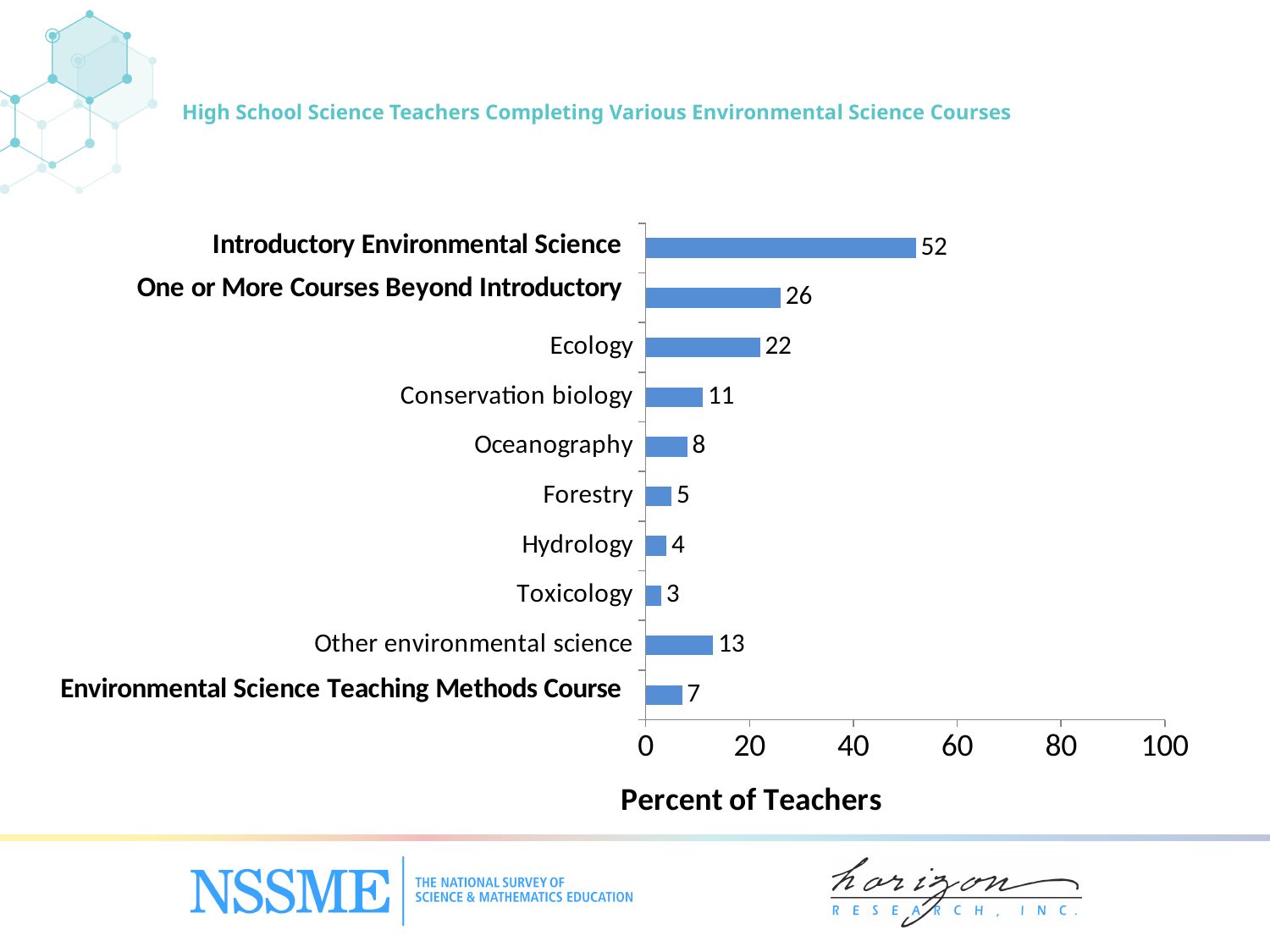
What is the difference between the values for Introductory Environmental Science and One or More Courses Beyond Introductory? 26 What kind of chart is shown on the slide? bar chart What is the value for Conservation biology? 11 Is the value for Oceanography greater or less than 20? less What percent of teachers completed an Environmental Science Teaching Methods Course? 7 What is the label of the horizontal axis? Percent of Teachers Which category has the highest percent of teachers? Introductory Environmental Science How many categories are shown in the chart? 10 Which is larger, the value for Ecology or the value for Other environmental science? Ecology What is the difference between the values for Hydrology and Toxicology? 1 What percent of teachers completed Introductory Environmental Science? 52 Which category has the lowest percent of teachers? Toxicology